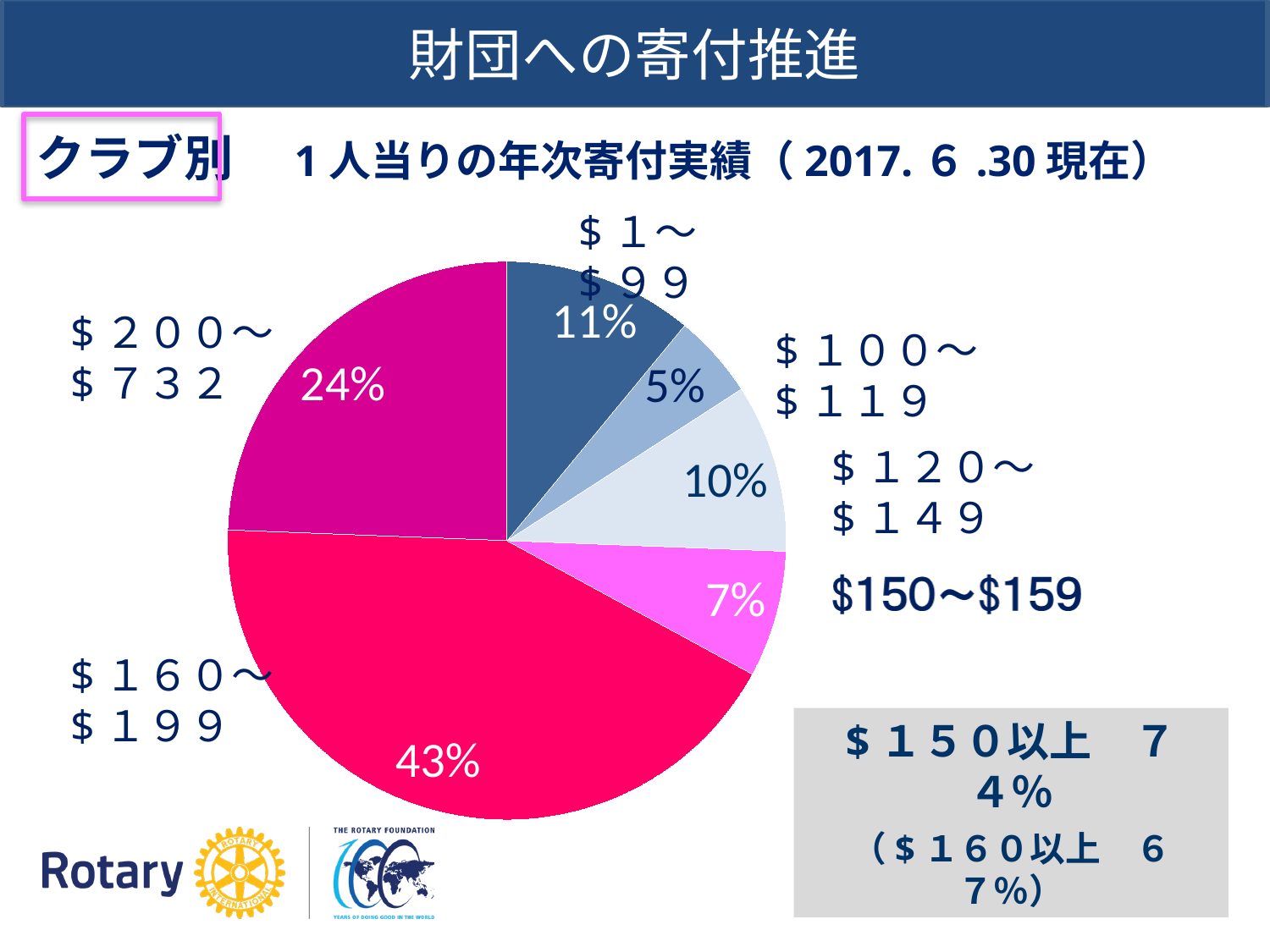
What percentage of the pie is the $150〜$159 slice? 7% What percentage of the pie is the $1〜$99 slice? 11% What is the difference in percentage points between the $160〜$199 slice and the $200〜$732 slice? 19 According to the grey box on the slide, what percentage of clubs gave $150 or more? 74% What kind of chart is shown on the slide? Pie chart Which category has the largest share of the pie? $160〜$199 Which slice is larger, $120〜$149 or $150〜$159? $120〜$149 How many slices does the pie chart have? 6 Which category has the smallest share of the pie? $100〜$119 What percentage of the pie is the $100〜$119 slice? 5% What percentage of the pie is the $160〜$199 slice? 43% What percentage of the pie is the $200〜$732 slice? 24%